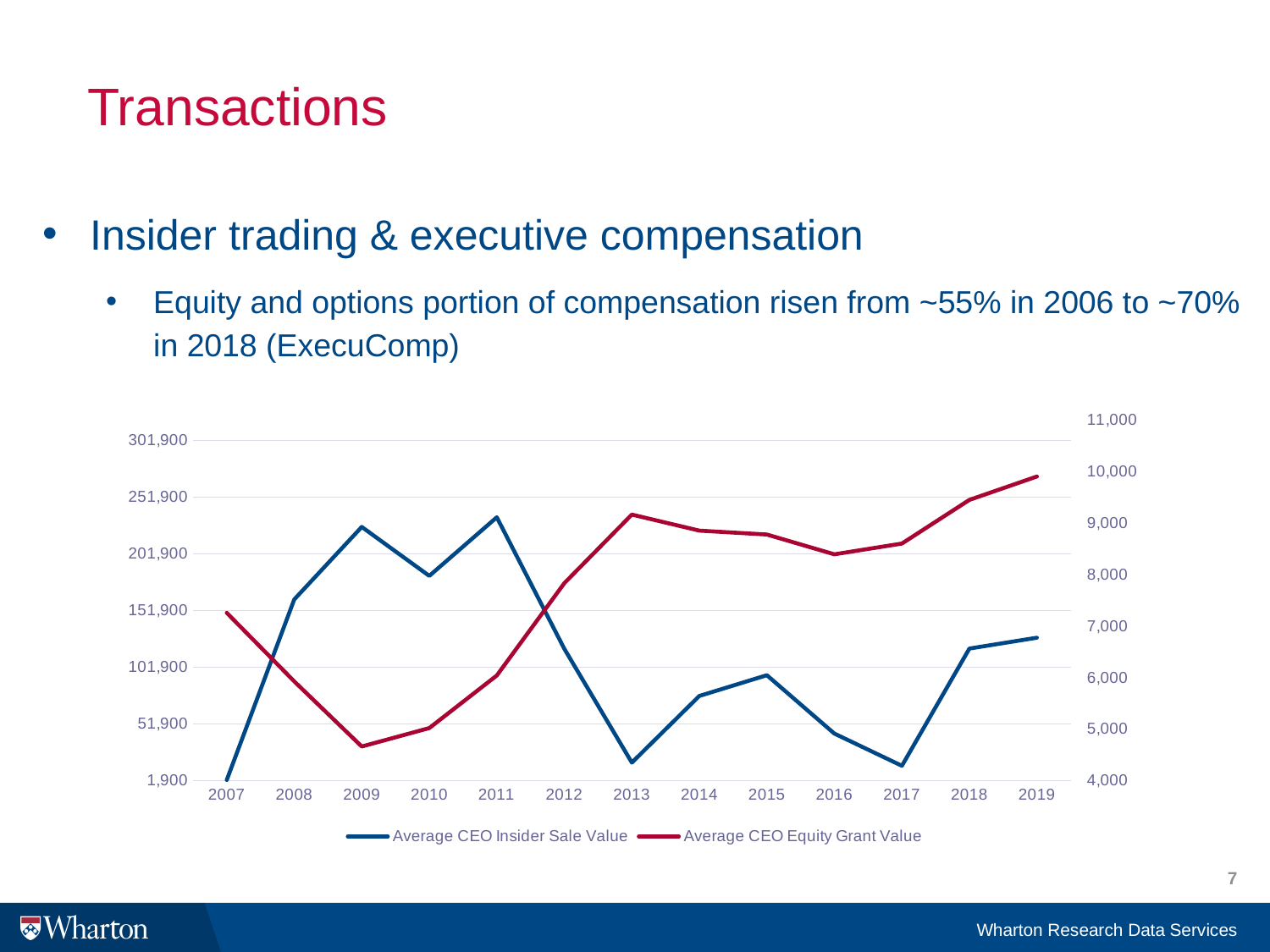
Which series is drawn in red on the chart? Average CEO Equity Grant Value Is the Average CEO Insider Sale Value in 2009 greater or less than 201,900? greater In which year is the Average CEO Equity Grant Value lowest? 2009 In which year is the Average CEO Insider Sale Value lowest? 2007 How many series does the chart's legend list? 2 Is the Average CEO Insider Sale Value in 2013 greater or less than 51,900? less Does the Average CEO Equity Grant Value rise or fall from 2009 to 2013? Rise In which year is the Average CEO Equity Grant Value highest? 2019 How many years are plotted along the x axis of the chart? 13 Which year has the higher Average CEO Insider Sale Value, 2008 or 2012? 2008 What kind of chart is shown on the slide? Line chart Is the Average CEO Equity Grant Value in 2009 greater or less than 5,000? less